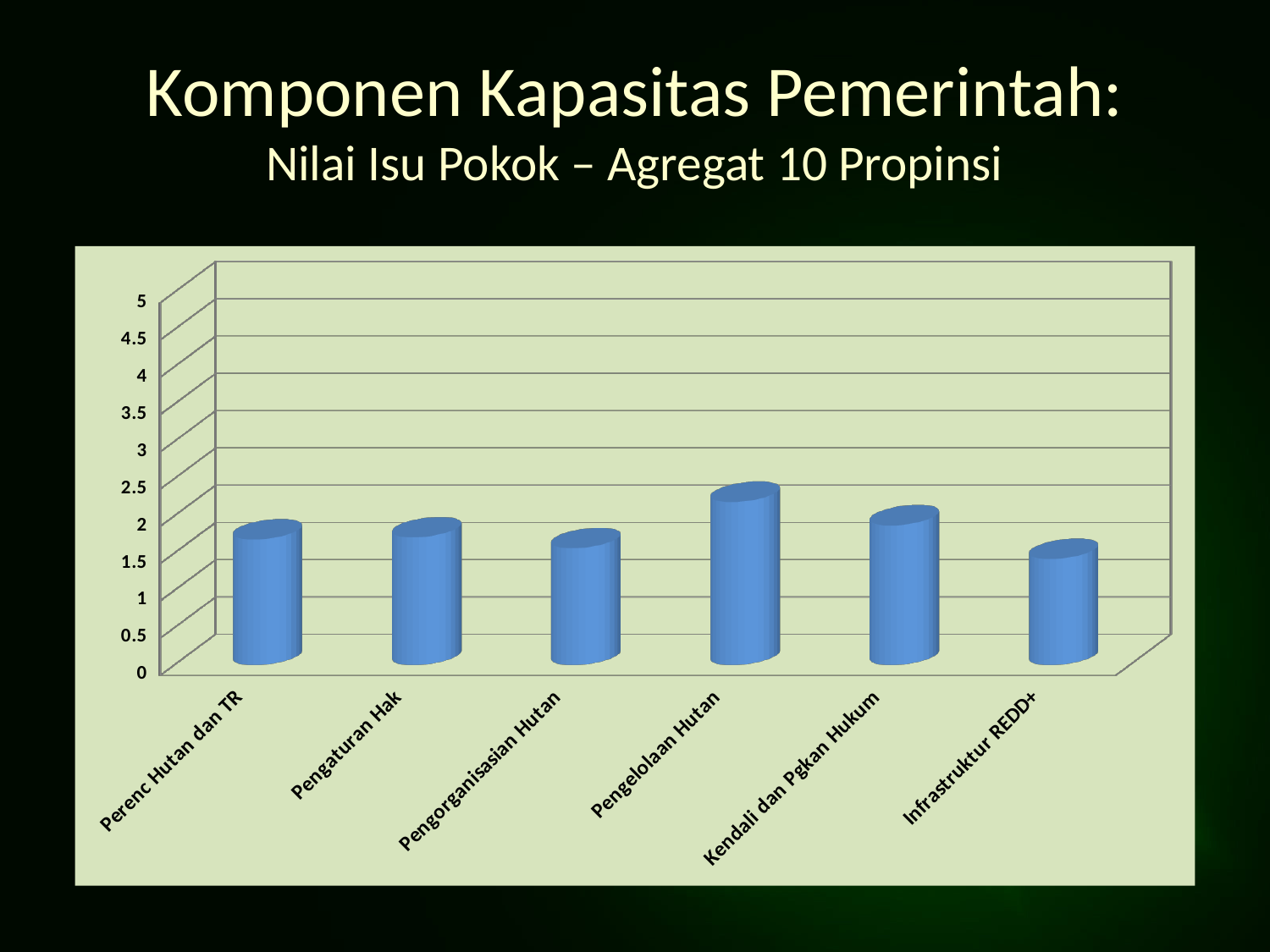
Is the value for Pengelolaan Hutan greater or less than 2? greater What is the subtitle of the slide below 'Komponen Kapasitas Pemerintah:'? Nilai Isu Pokok – Agregat 10 Propinsi How many categories are plotted on the chart? 6 Which is larger, the value for Pengelolaan Hutan or the value for Infrastruktur REDD+? Pengelolaan Hutan Is the value for Pengelolaan Hutan greater or less than 3? less Which category has the highest value? Pengelolaan Hutan Which is larger, the value for Kendali dan Pgkan Hukum or the value for Infrastruktur REDD+? Kendali dan Pgkan Hukum What is the highest value shown on the vertical axis? 5 Is the value for Infrastruktur REDD+ greater or less than 2? less Which is larger, the value for Pengelolaan Hutan or the value for Pengaturan Hak? Pengelolaan Hutan What kind of chart is shown on the slide? bar chart